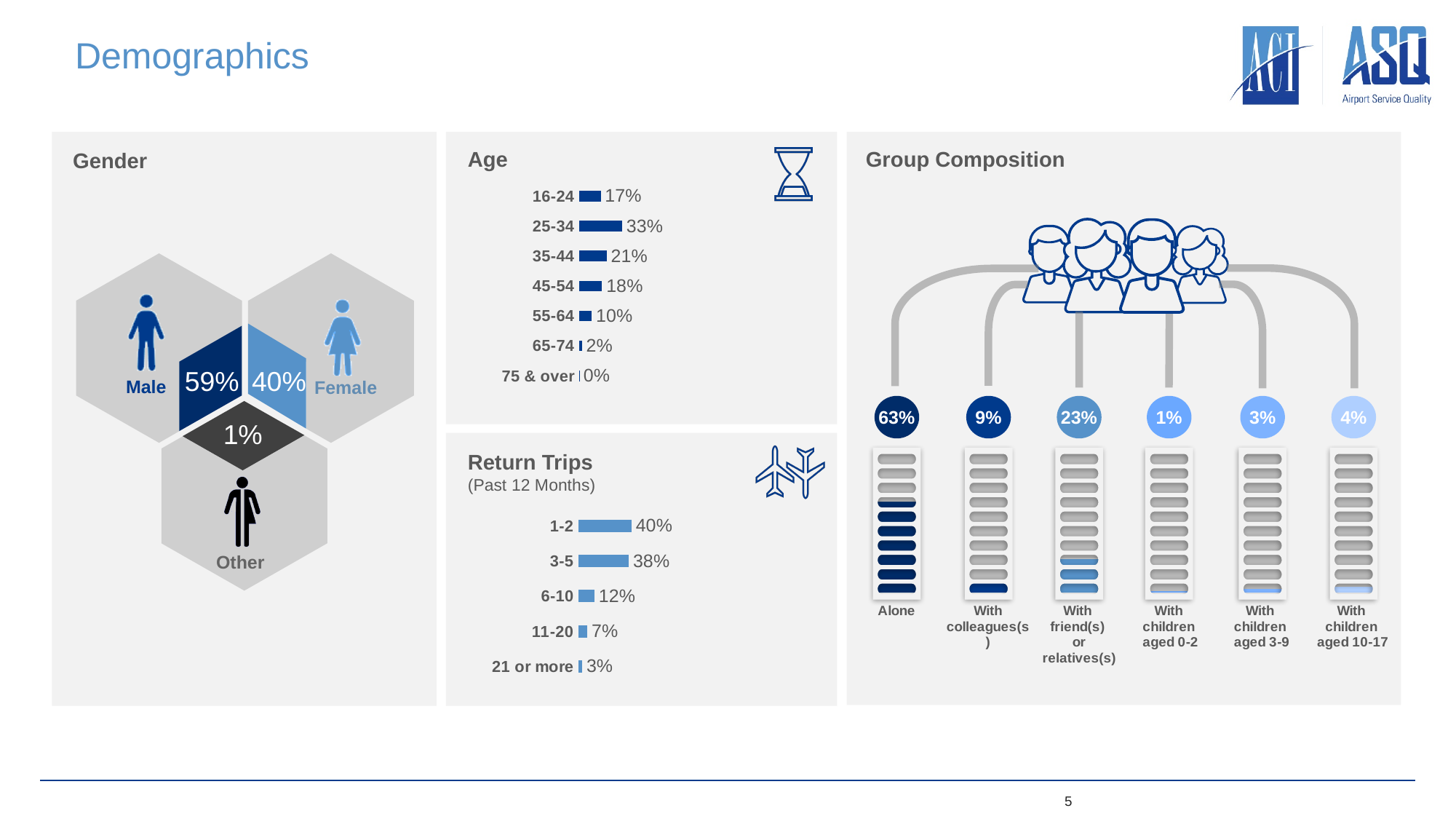
In the Age chart, which age group has the highest percentage? 25-34 In the Group Composition chart, which category has the lowest percentage? With children aged 0-2 In the Gender chart, which is larger, the Male or Female percentage? Male In the Return Trips chart, what kind of chart is used? bar chart In the Return Trips chart, what percentage is shown for 6-10 trips? 12% In the Age chart, which age group has the lowest percentage? 75 & over In the Return Trips chart, what is the difference between the 1-2 and 3-5 percentages? 2% In the Group Composition chart, what percentage is shown for 'With friend(s) or relatives(s)'? 23% In the Age chart, what is the difference between the 35-44 and 45-54 percentages? 3% In the Age chart, how many age groups are listed? 7 In the Age chart, what percentage is shown for the 25-34 age group? 33% In the Return Trips chart, which category has the highest percentage? 1-2